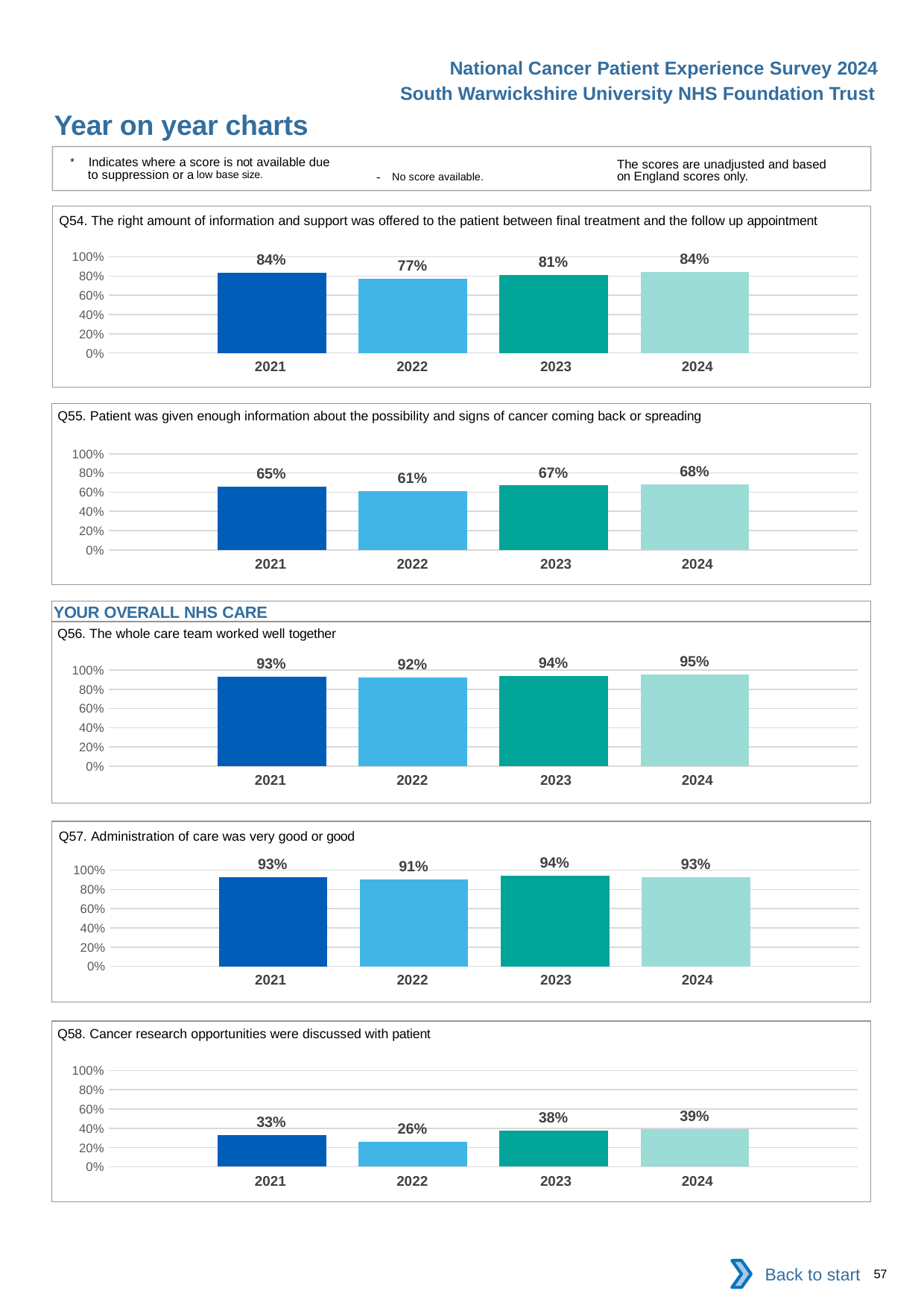
In the Q55 chart, do the values rise or fall from 2022 to 2024? Rise In the Q58 chart, which year has the lowest value? 2022 How many years are shown on the x axis of the Q56 chart? 4 In the Q55 chart, which year has the lowest value? 2022 In the Q58 chart, what is the value for 2021? 33% What kind of chart is the Q57 chart? Bar chart In the Q56 chart, what is the value for 2024? 95% In the Q54 chart, is the value for 2021 or 2023 larger? 2021 In the Q58 chart, what is the difference between the 2023 and 2022 values? 12% In the Q54 chart, what is the value for 2022? 77% In the Q57 chart, which year has the highest value? 2023 In the Q55 chart, what is the difference between the 2024 and 2021 values? 3%